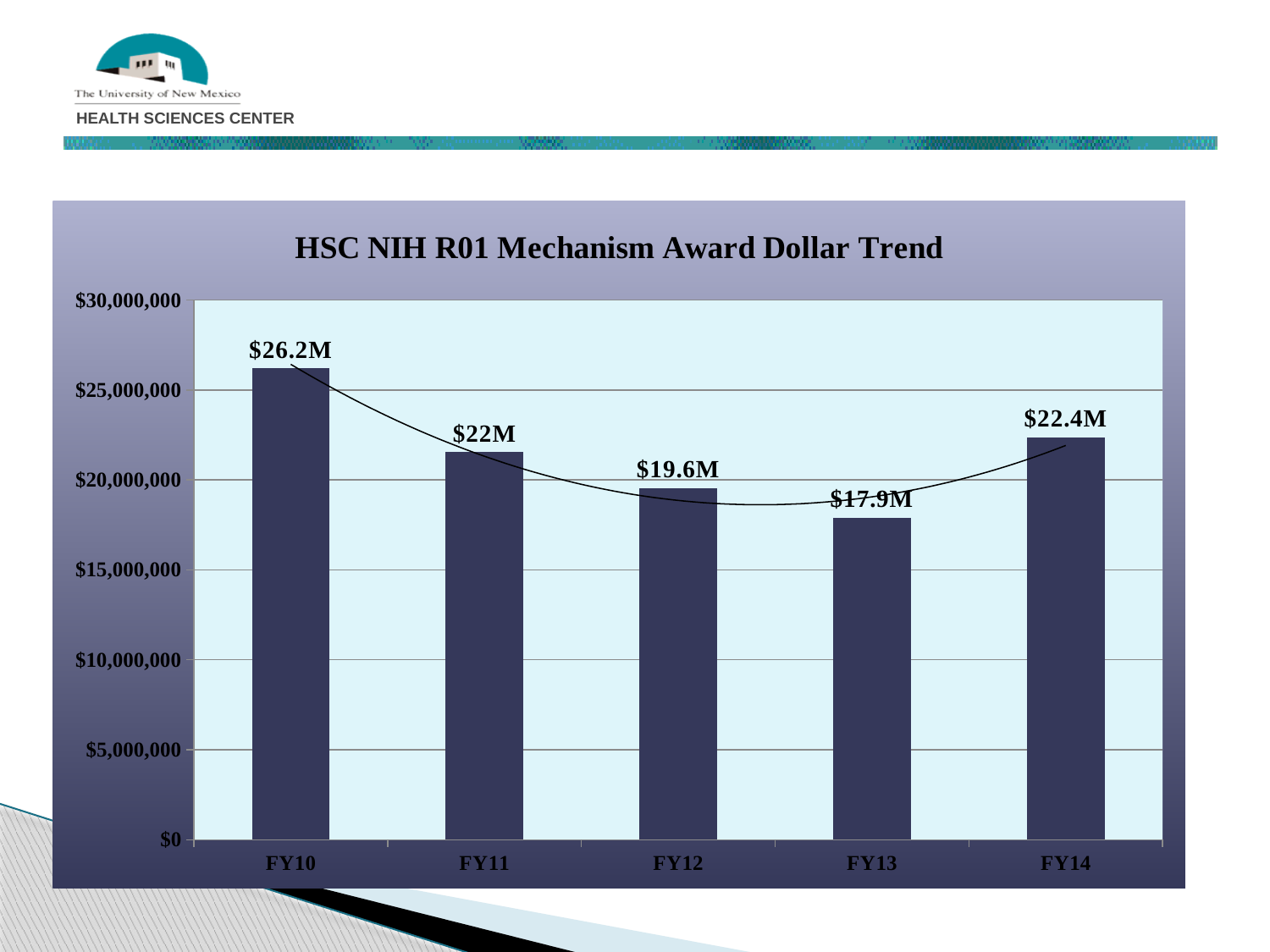
What is the value for FY13? $17.9M Which fiscal year has the highest award dollar value? FY10 What kind of chart is shown on the slide? bar chart What is the value for FY10? $26.2M What is the value for FY14? $22.4M How many fiscal years are shown on the chart? 5 Which fiscal year has the lowest award dollar value? FY13 Do the values rise or fall from FY10 to FY13? fall What is the title of the chart? HSC NIH R01 Mechanism Award Dollar Trend Is the value for FY12 greater or less than $20,000,000? less What is the difference between the FY10 and FY13 values? $8.3M Which is larger, the value for FY11 or the value for FY14? FY14